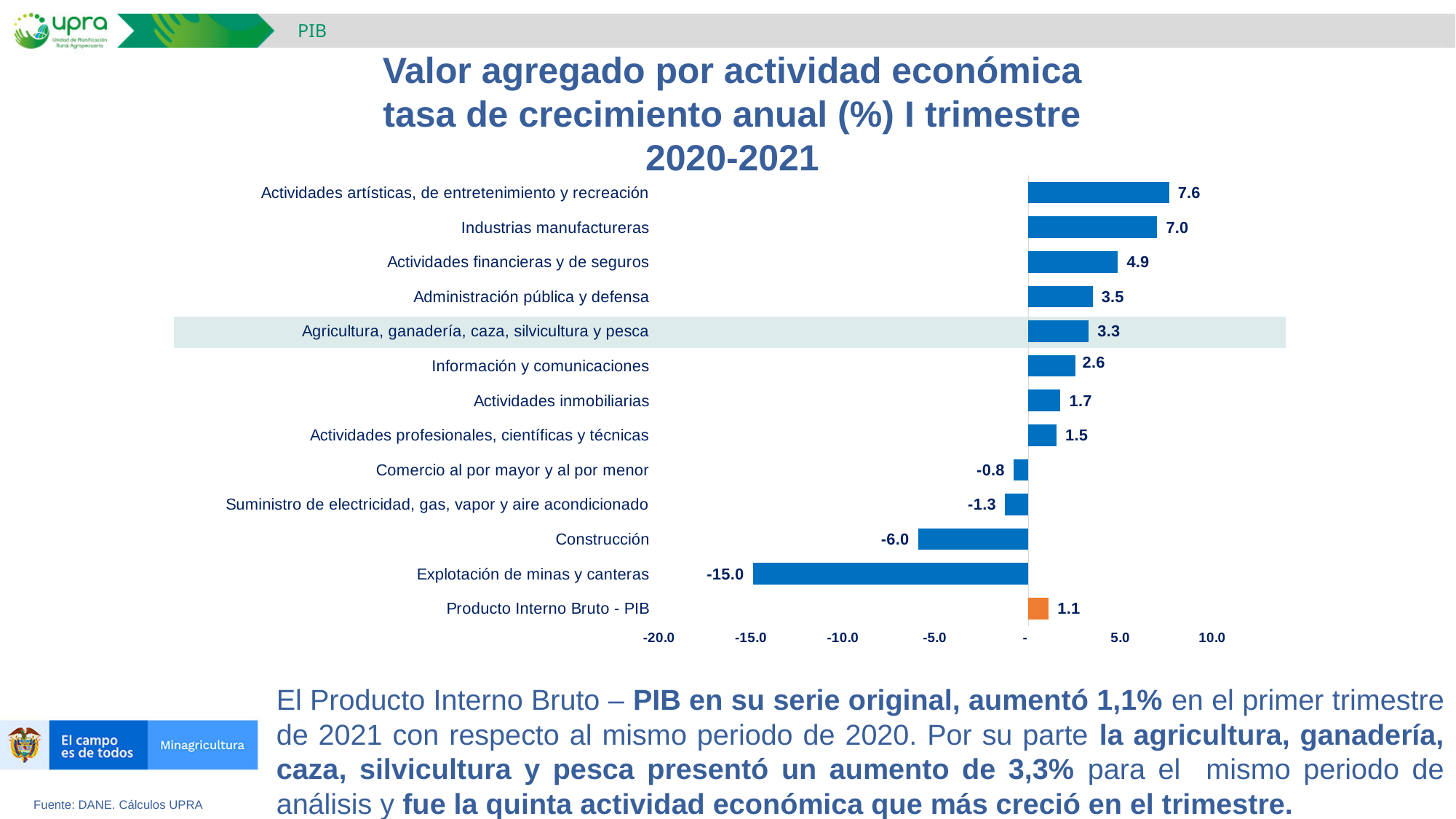
What is the difference between the values for Industrias manufactureras and Actividades financieras y de seguros? 2.1 Which economic activity has the lowest growth rate in the chart? Explotación de minas y canteras What is the annual growth rate shown for Agricultura, ganadería, caza, silvicultura y pesca? 3.3 How many categories (bars) are shown in the chart? 13 What is the value shown for Comercio al por mayor y al por menor? -0.8 Which is larger, the value for Administración pública y defensa or the value for Información y comunicaciones? Administración pública y defensa Which bar in the chart is coloured orange instead of blue? Producto Interno Bruto - PIB Which economic activity has the highest growth rate in the chart? Actividades artísticas, de entretenimiento y recreación What is the value shown for Construcción? -6.0 Is the value for Explotación de minas y canteras greater or less than -10.0? less What type of chart is shown on the slide? Bar chart What value is shown for Producto Interno Bruto - PIB? 1.1